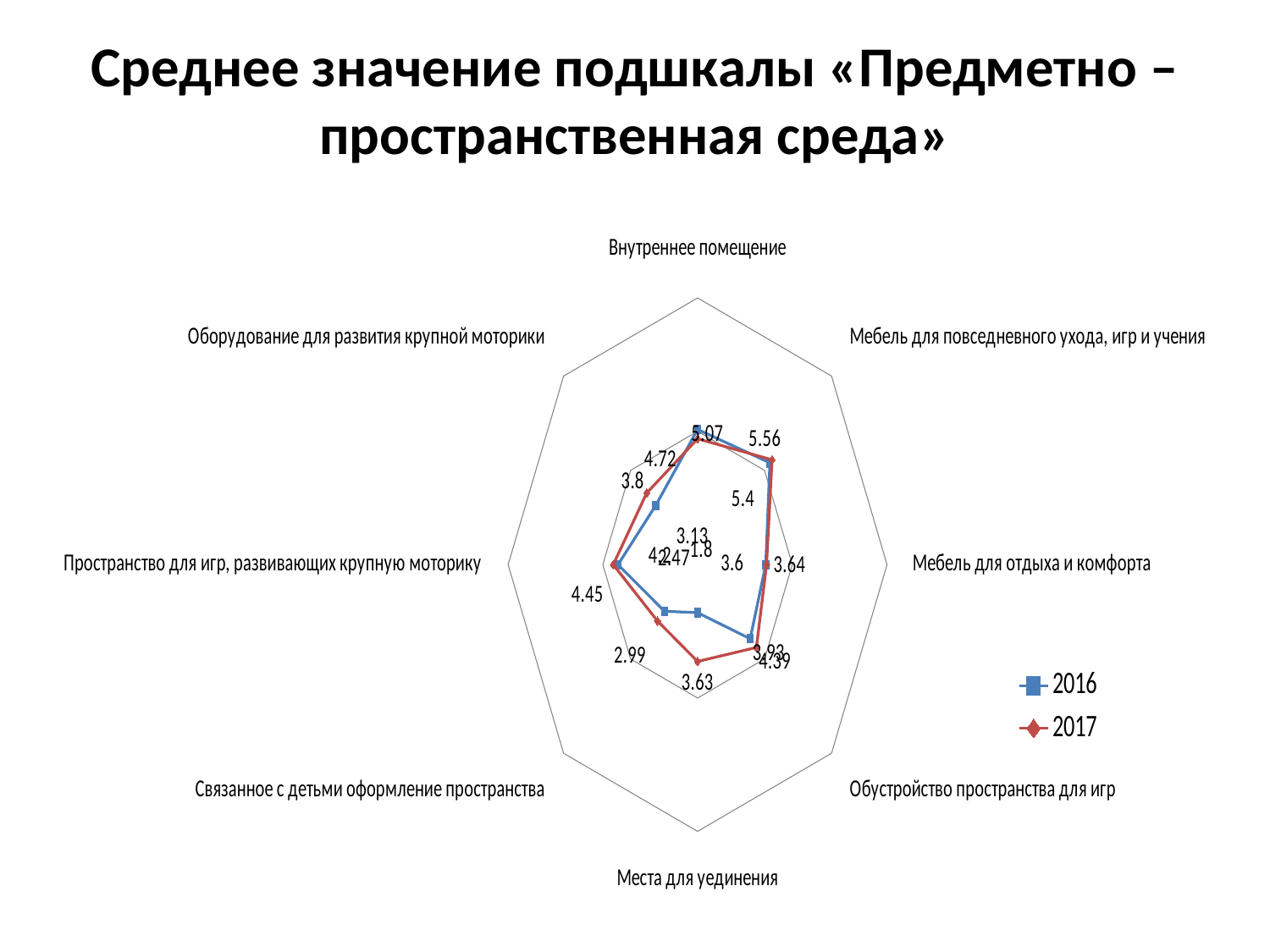
What kind of chart is shown on the slide? radar chart What is the 2016 value for «Мебель для повседневного ухода, игр и учения»? 5.4 How many categories (axes) does the radar chart have? 8 Which years are listed in the legend? 2016 and 2017 What is the 2017 value for «Места для уединения»? 3.63 What is the difference between the 2017 and 2016 values for «Мебель для повседневного ухода, игр и учения»? 0.16 For «Мебель для повседневного ухода, игр и учения», which year has the larger value, 2016 or 2017? 2017 How many series does the legend list? 2 What is the 2017 value for «Пространство для игр, развивающих крупную моторику»? 4.45 Which category has the highest 2017 value? Мебель для повседневного ухода, игр и учения What is the 2017 value for «Мебель для повседневного ухода, игр и учения»? 5.56 What is the 2017 value for «Мебель для отдыха и комфорта»? 3.64